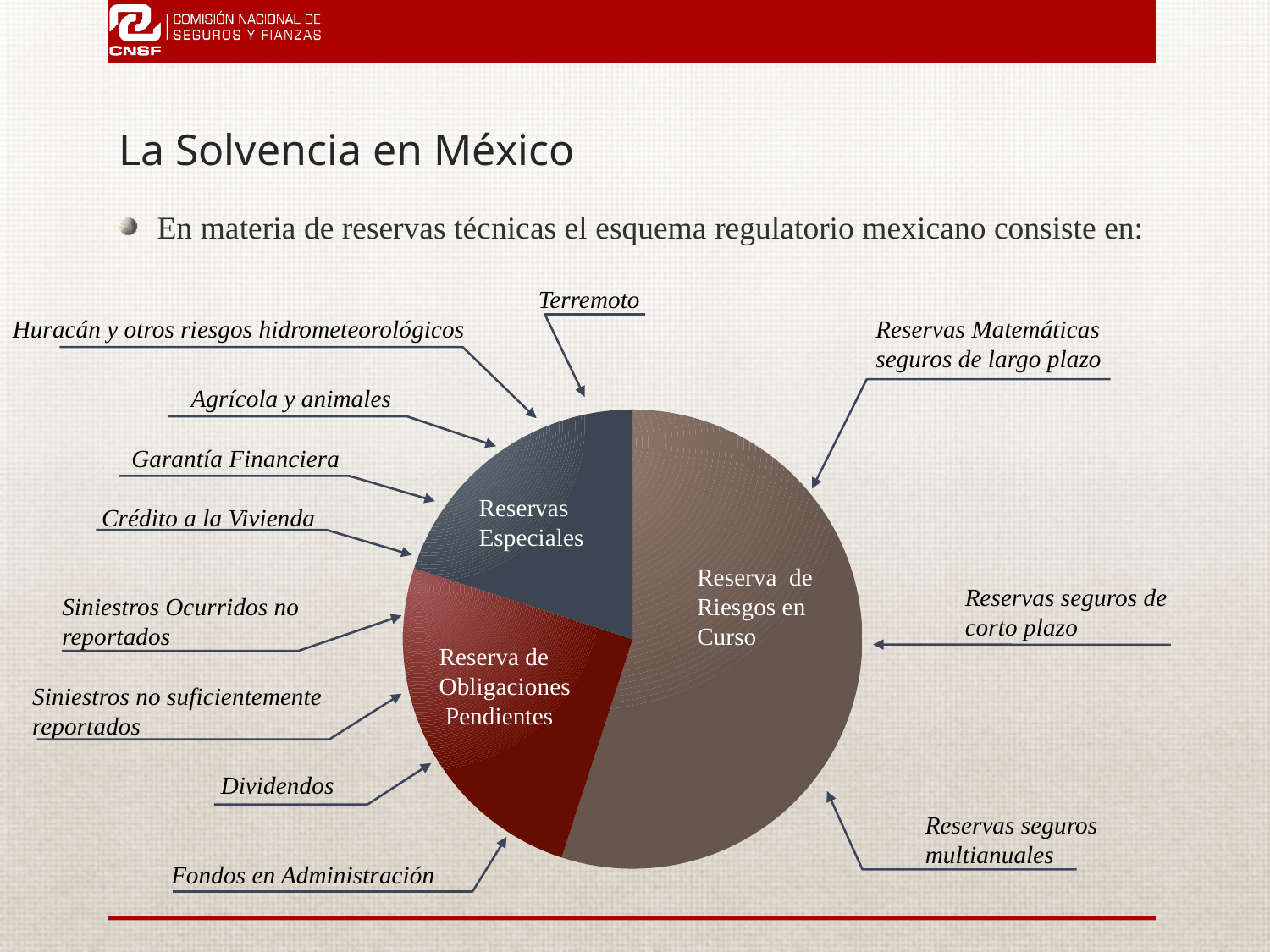
Does the Reserva de Riesgos en Curso slice take up more or less than half of the pie? more Which slice of the pie chart do the arrows labelled Terremoto and Garantía Financiera point to? Reservas Especiales Which slice is larger: Reservas Especiales or Reserva de Obligaciones Pendientes? Reserva de Obligaciones Pendientes Which slice of the pie chart is coloured dark red? Reserva de Obligaciones Pendientes Which slice is larger: Reserva de Riesgos en Curso or Reservas Especiales? Reserva de Riesgos en Curso Which slice of the pie chart is the smallest? Reservas Especiales How many slices does the pie chart have? 3 What kind of chart is shown on the slide? pie chart Which slice of the pie chart is the largest? Reserva de Riesgos en Curso